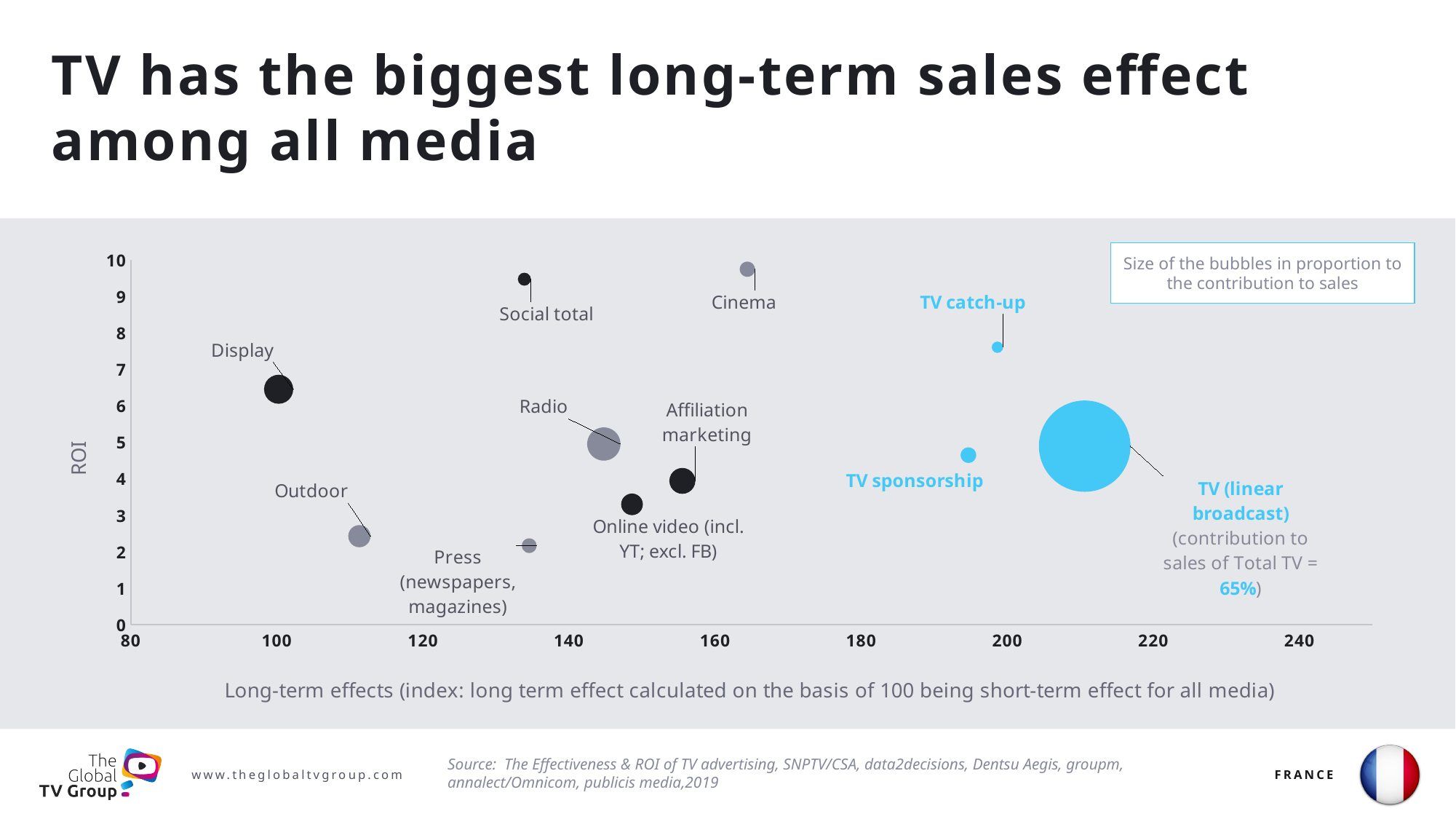
Which has the higher ROI, TV catch-up or TV sponsorship? TV catch-up Which medium has the lowest long-term effects index on the chart? Display Is the ROI for Outdoor greater or less than 4? less Is the ROI for Display greater or less than 5? greater What is the contribution to sales of Total TV shown for TV (linear broadcast)? 65% How many media bubbles are plotted on the chart? 11 What kind of chart is shown on the slide? bubble chart Is the long-term effects index for TV (linear broadcast) greater or less than 200? greater Which medium has the highest long-term effects index on the chart? TV (linear broadcast) Which has the higher ROI, Display or Outdoor? Display According to the note on the chart, what is the size of the bubbles proportional to? the contribution to sales